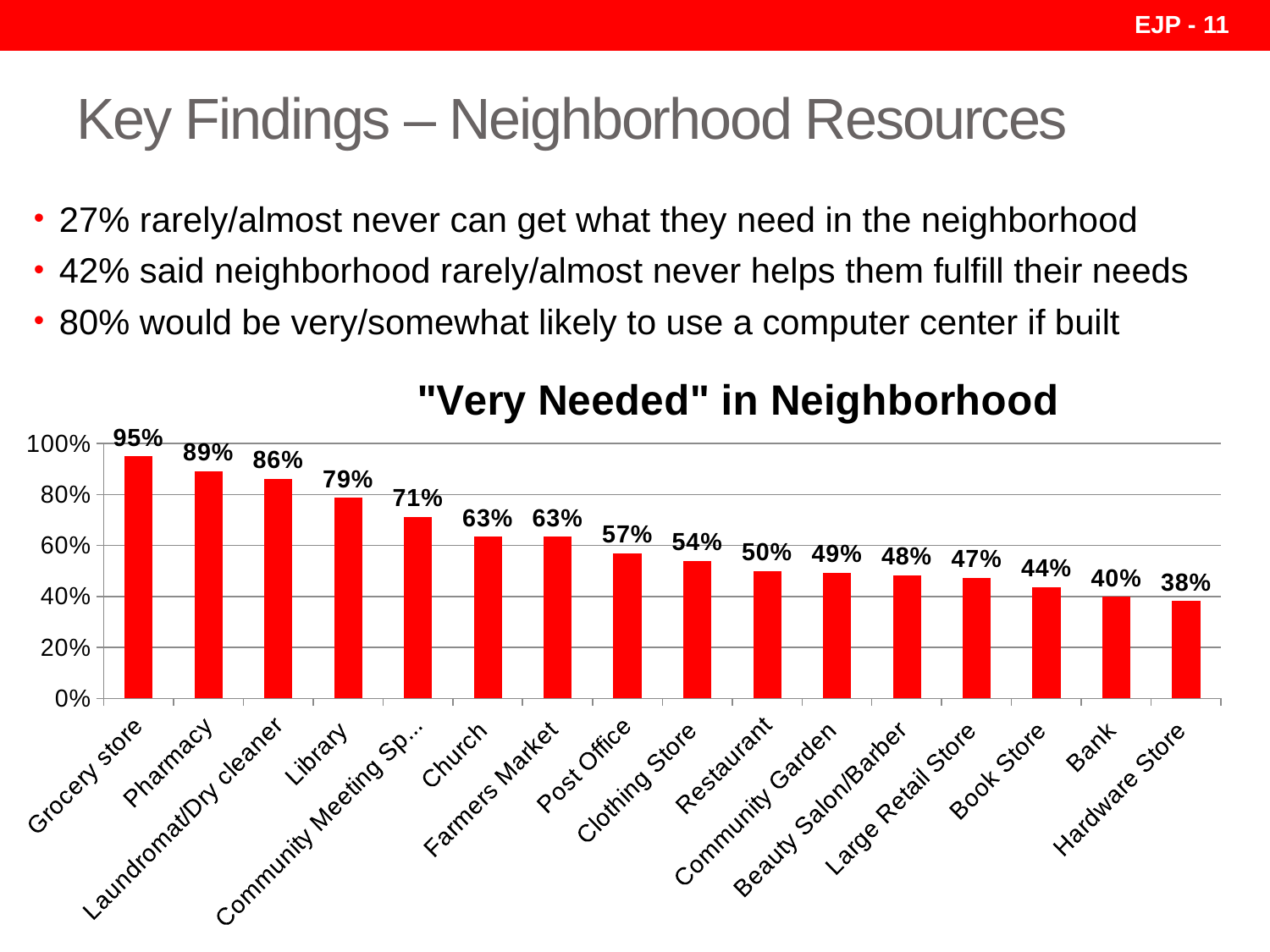
What is the value for Library? 79% Which is larger, the value for Church or the value for Restaurant? Church What is the value for Post Office? 57% How many categories are shown on the x axis? 16 Which category has the lowest value? Hardware Store What is the value for Grocery store? 95% What kind of chart is shown on the slide? Bar chart Do the values rise or fall from left to right along the x axis? Fall Which category has the highest value? Grocery store What is the title of the chart? "Very Needed" in Neighborhood What is the value for Bank? 40% What is the difference between the values for Pharmacy and Hardware Store? 51%